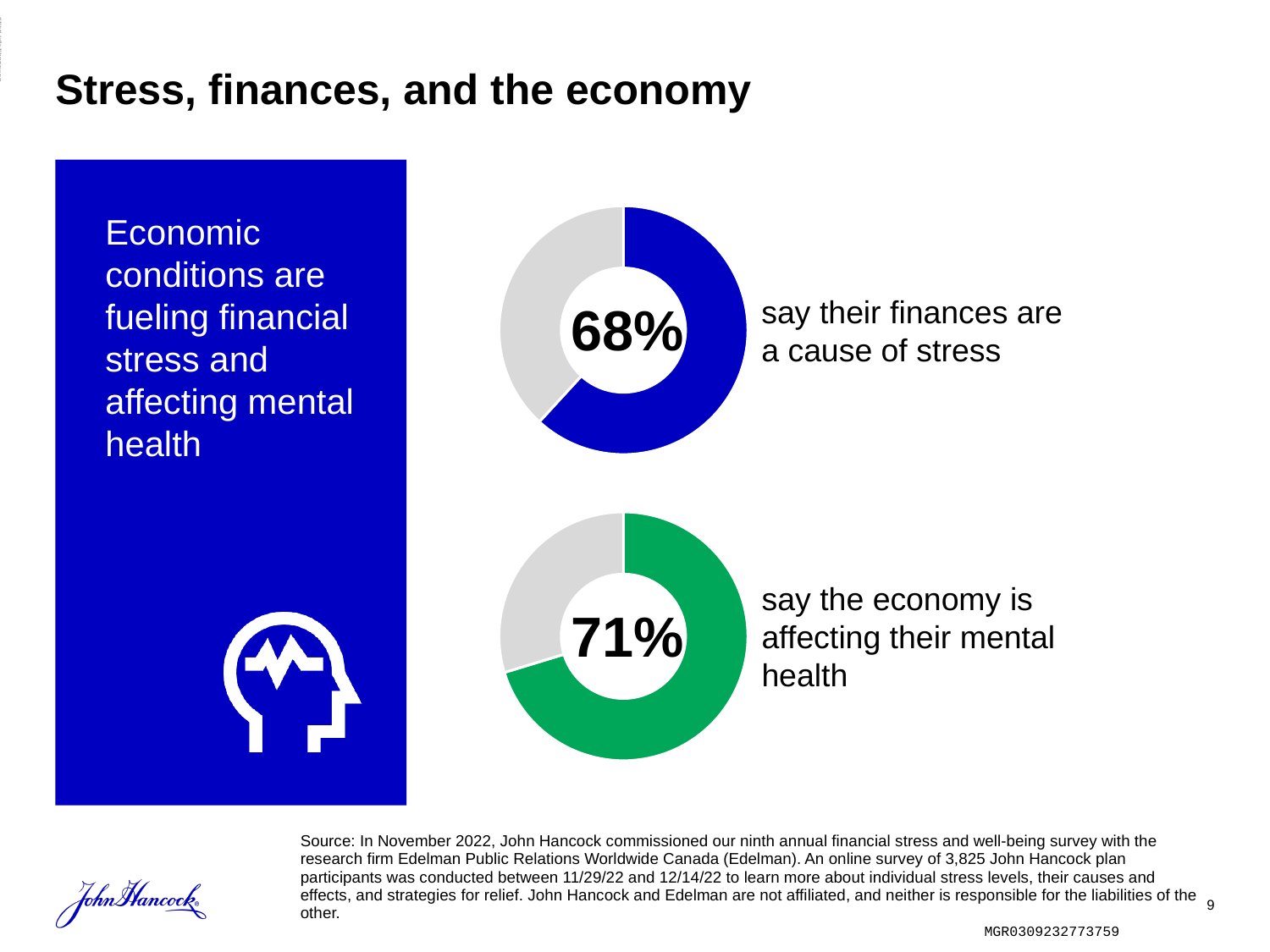
What colour is the highlighted segment in the bottom donut chart showing 71%? green Which is larger: the share who say their finances are a cause of stress (top chart) or the share who say the economy is affecting their mental health (bottom chart)? the share who say the economy is affecting their mental health (71%) In the bottom donut chart, what percentage of respondents say the economy is affecting their mental health? 71% In the top donut chart, what percentage of respondents say their finances are a cause of stress? 68% In the top donut chart, is the highlighted value greater or less than 50%? greater What is the difference in percentage points between the value in the bottom donut chart (71%) and the value in the top donut chart (68%)? 3 percentage points What kind of chart is used to show the 68% figure in the top chart? donut (pie) chart In the bottom donut chart, is the highlighted value greater or less than 75%? less What colour is the highlighted segment in the top donut chart showing 68%? blue How many donut charts are shown on the slide? 2